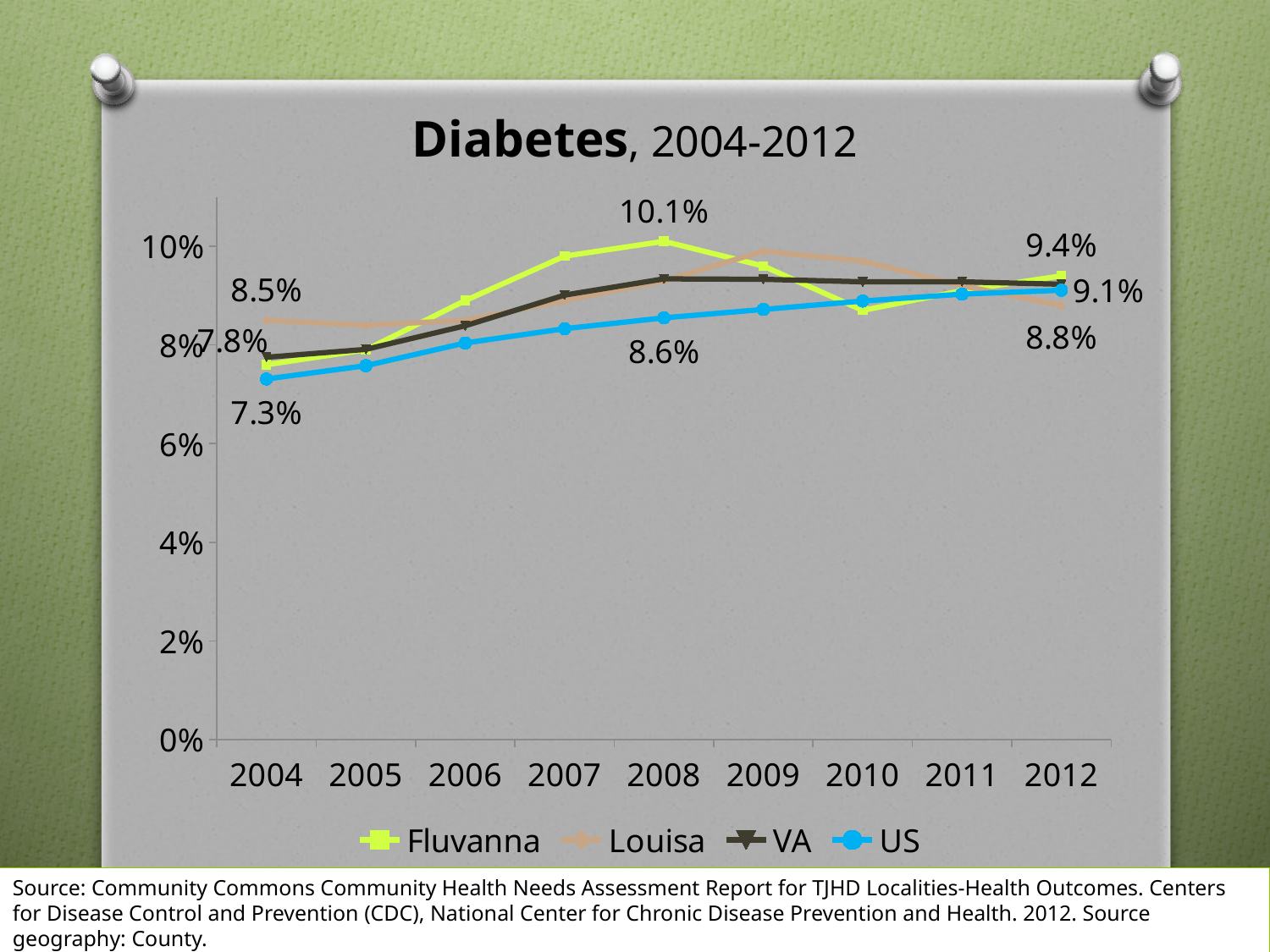
What is the US diabetes rate in 2004? 7.3% Does the US diabetes rate rise or fall from 2004 to 2012? rise By how many percentage points did the US diabetes rate rise from 2004 to 2012? 1.8 percentage points What is the Louisa diabetes rate in 2012? 8.8% How many years are shown on the x axis? 9 What is the US diabetes rate in 2008? 8.6% Which series has the highest value in 2008? Fluvanna In 2012, which is higher: Fluvanna or Louisa? Fluvanna What is the Fluvanna diabetes rate in 2012? 9.4% How many series does the legend list? 4 What is the Fluvanna diabetes rate in 2008? 10.1% Is the Fluvanna value for 2007 greater or less than 8%? greater